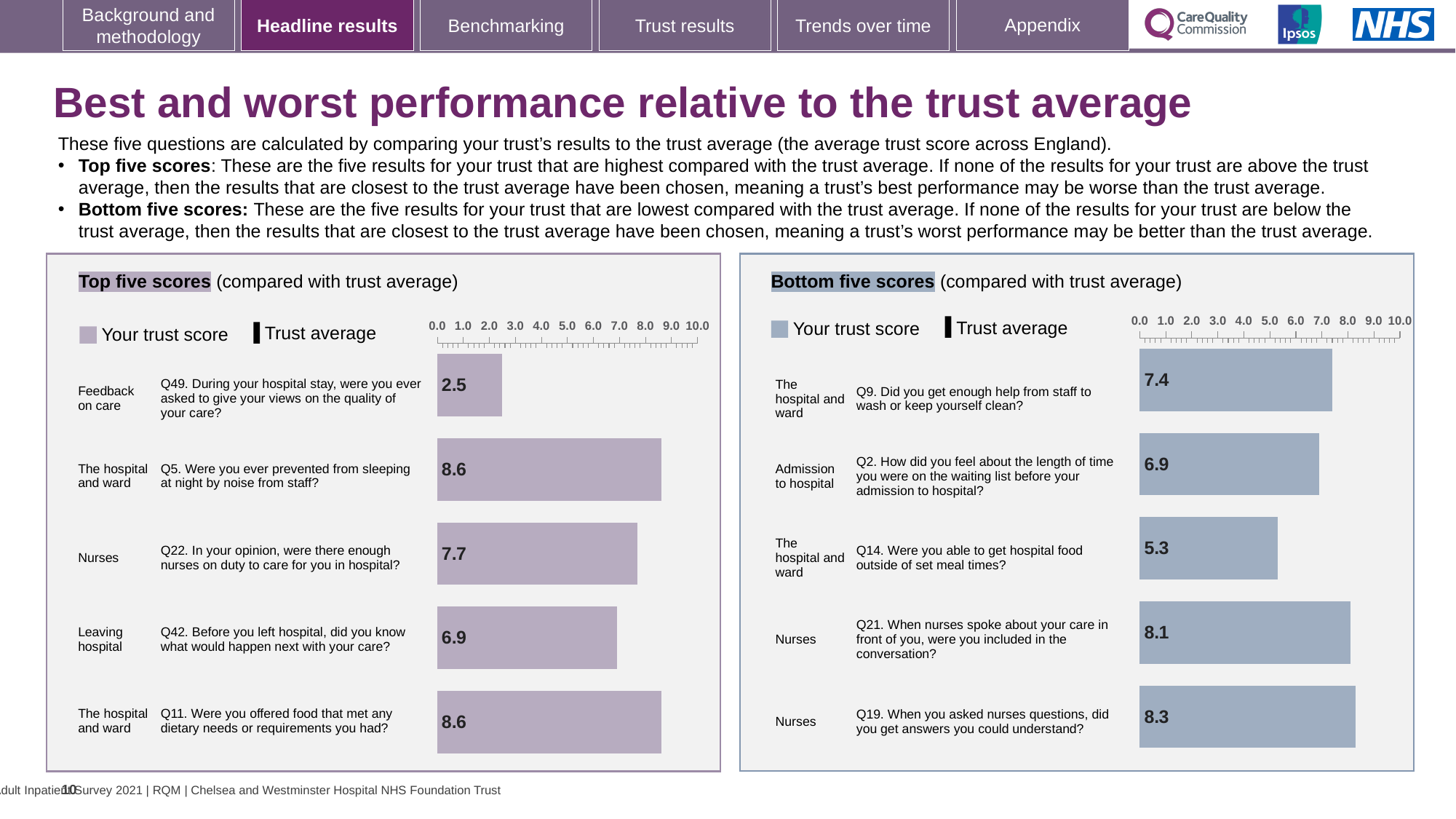
What kind of chart is the Top five scores chart? Bar chart In the Top five scores chart, what is the trust score for Q49 (During your hospital stay, were you ever asked to give your views on the quality of your care?)? 2.5 How many questions are shown in the Bottom five scores chart? 5 In the Top five scores chart, what is the trust score for Q22 about enough nurses on duty? 7.7 In the Top five scores chart, what is the difference between the trust scores for Q5 and Q49? 6.1 In the Top five scores chart, which question has the lowest trust score? Q49 In the Bottom five scores chart, what is the difference between the trust scores for Q19 and Q14? 3.0 In the Bottom five scores chart, what is the trust score for Q14 (Were you able to get hospital food outside of set meal times?)? 5.3 In the Bottom five scores chart, which question has the highest trust score? Q19 In the Bottom five scores chart, which question has the lowest trust score? Q14 In the Bottom five scores chart, what is the trust score for Q9 about getting enough help from staff to wash or keep yourself clean? 7.4 In the Top five scores chart, which has the larger trust score, Q22 or Q42? Q22